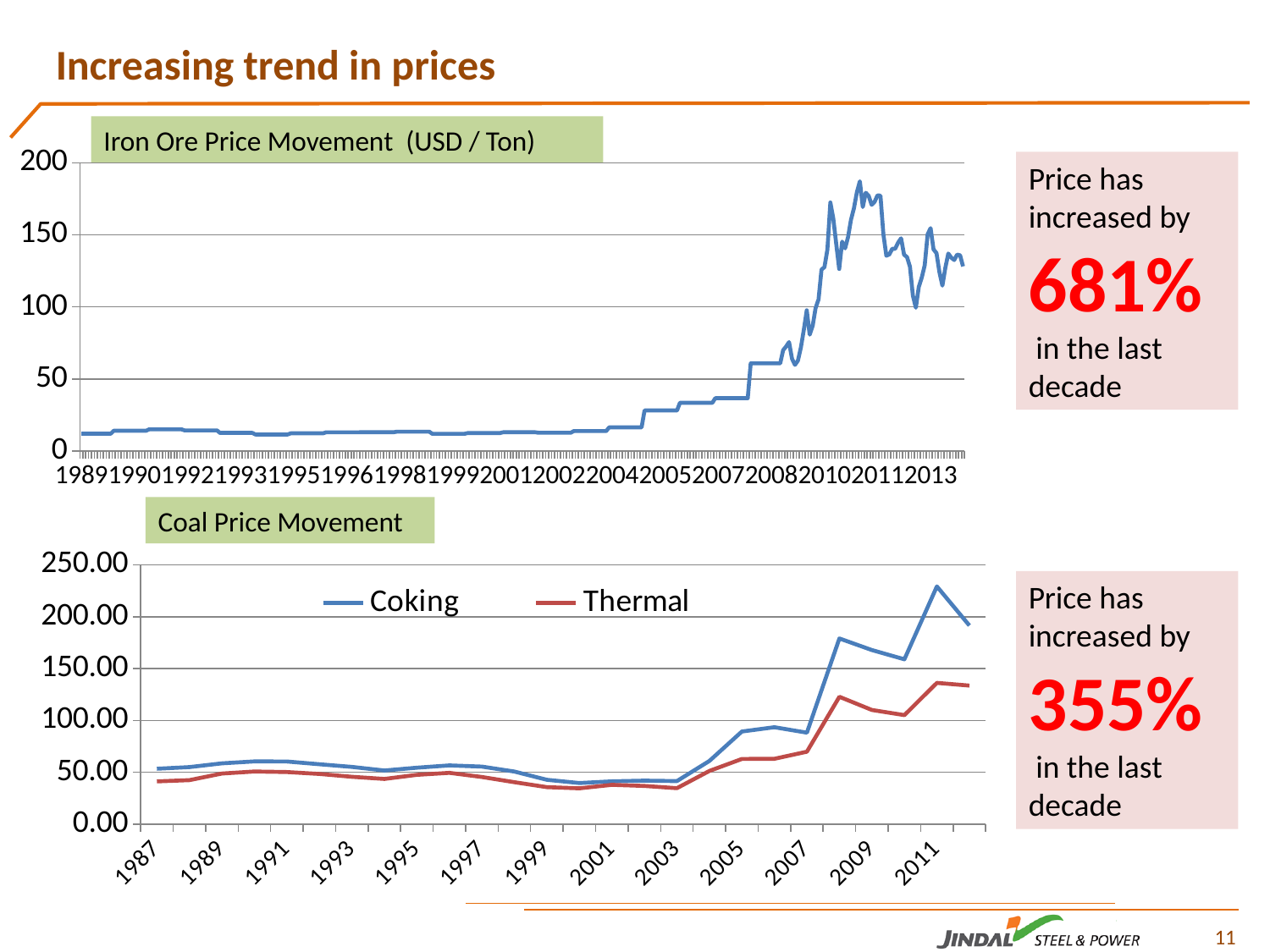
In the Coal Price Movement chart, which colour is the Thermal line? red What kind of chart is the Coal Price Movement chart? line chart What are the two series named in the legend of the Coal Price Movement chart? Coking and Thermal Overall, do iron ore prices rise or fall from 1989 to 2013 in the Iron Ore Price Movement chart? rise In the Coal Price Movement chart, is the Thermal value in 2011 greater or less than 100.00? greater How many series does the legend of the Coal Price Movement chart list? 2 In the Iron Ore Price Movement chart, is the value in 1989 greater or less than 50? less In the Coal Price Movement chart, is the Coking value in 2011 greater or less than 200.00? greater In the Coal Price Movement chart, which series has the higher value in 2011, Coking or Thermal? Coking What kind of chart is the Iron Ore Price Movement chart? line chart